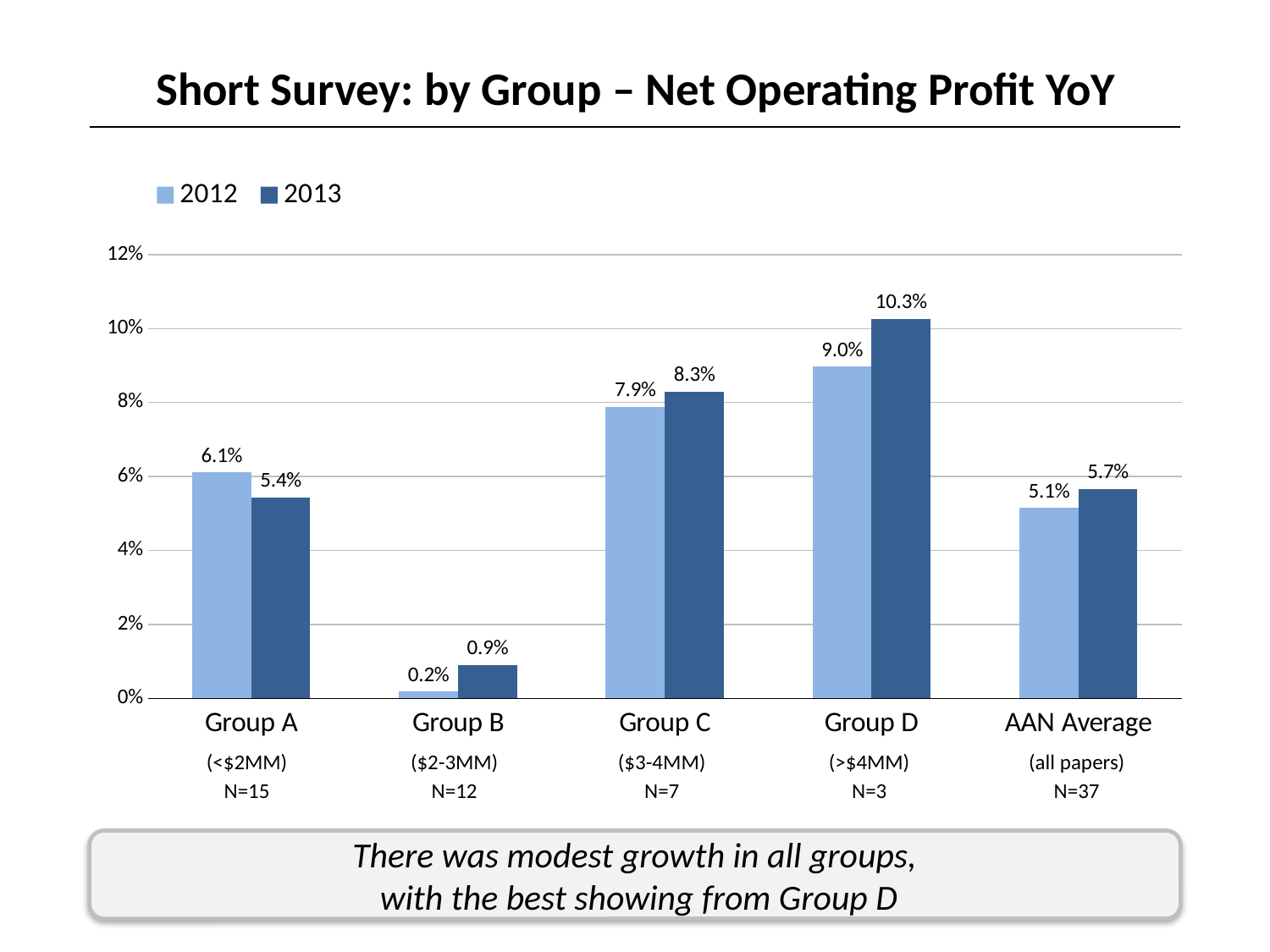
How many groups are shown on the x axis? 5 What kind of chart is shown on the slide? Bar chart What is the title of the slide? Short Survey: by Group – Net Operating Profit YoY How many series does the legend list? 2 What is the 2012 value for Group B? 0.2% Is the 2012 value for Group D greater or less than 8%? greater What is the difference between the 2013 and 2012 values for Group C? 0.4% What is the 2013 value for Group D? 10.3% Which group has the lowest 2012 value? Group B What is the 2013 value for AAN Average? 5.7% Which is larger for Group A, the 2012 value or the 2013 value? 2012 Which group has the highest 2013 value? Group D